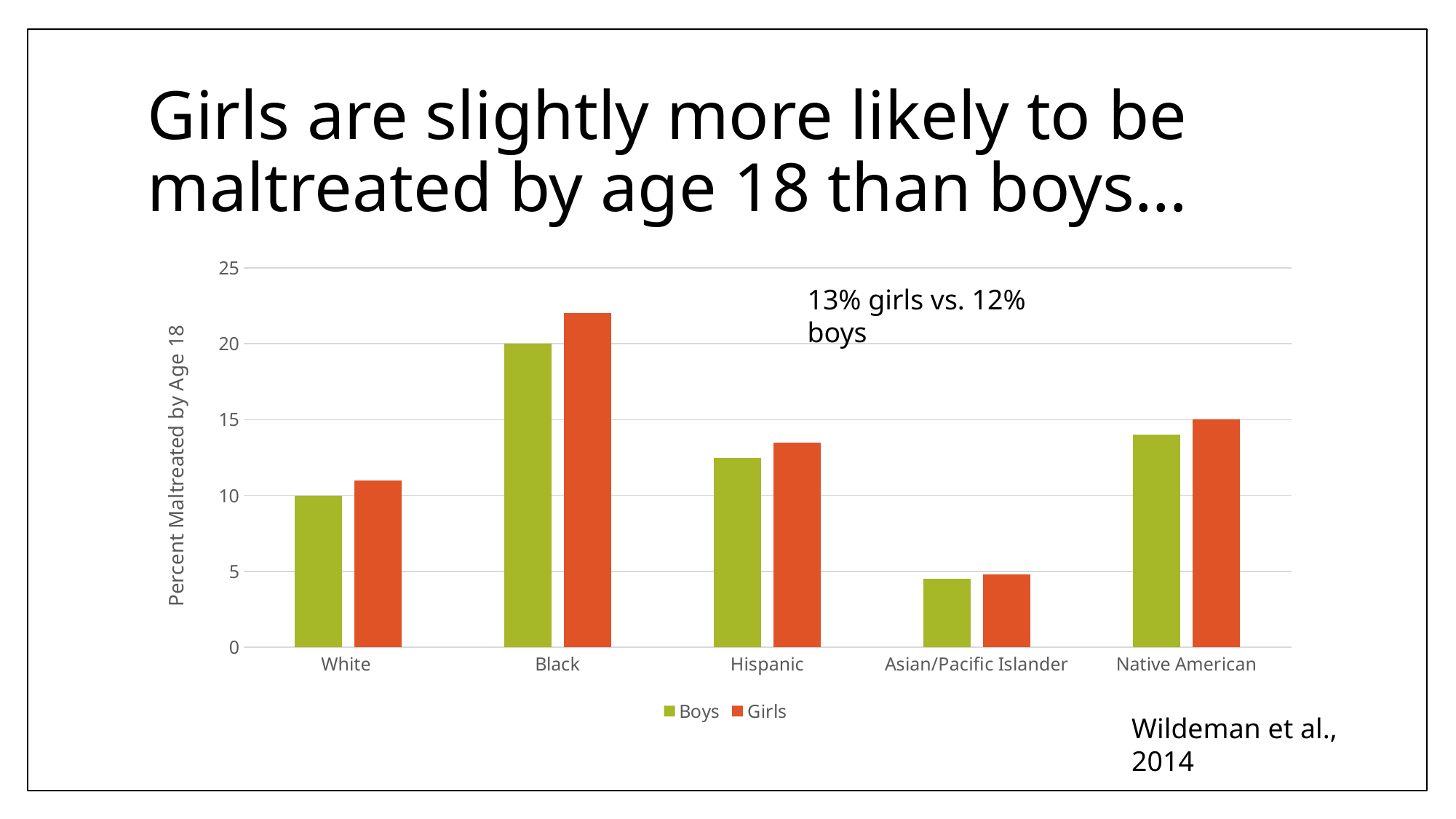
What is the percent maltreated by age 18 for Black boys? 20 Which category has the lowest bar for Boys? Asian/Pacific Islander What is the percent maltreated by age 18 for Native American girls? 15 What is the title of the y axis? Percent Maltreated by Age 18 Which category has the highest bar for Girls? Black Is the value for Black girls greater or less than 20? greater Which is larger, the Boys value for Black or the Boys value for Hispanic? Black How many racial/ethnic categories are shown on the x axis? 5 What type of chart is shown on the slide? Bar chart Is the value for Asian/Pacific Islander boys greater or less than 5? less What is the percent maltreated by age 18 for White boys? 10 How many series does the legend list? 2